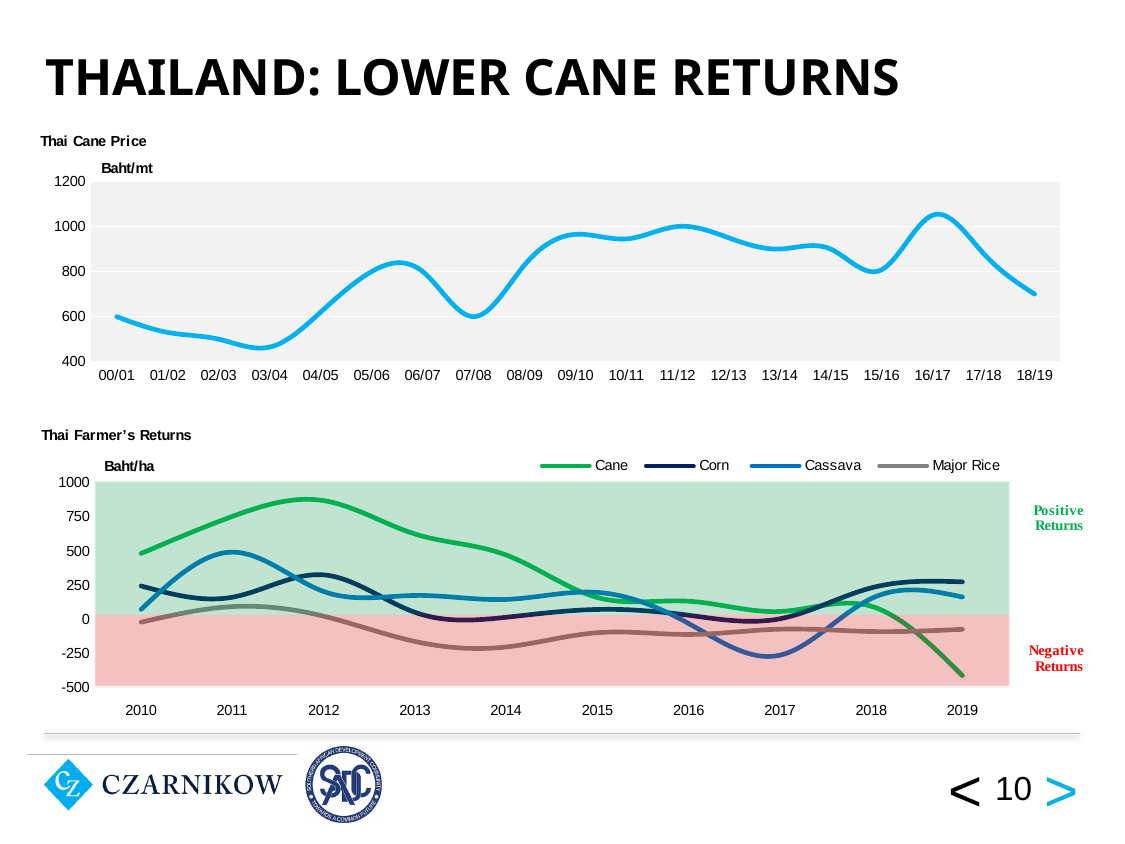
In the Thai Farmer's Returns chart, is the Cane value for 2019 greater or less than -250? less How many seasons are plotted on the x axis of the Thai Cane Price chart? 19 In the Thai Farmer's Returns chart, which is larger in 2012, Cane or Corn? Cane What kind of chart is the Thai Cane Price chart? line chart How many series does the legend of the Thai Farmer's Returns chart list? 4 How many years are plotted on the x axis of the Thai Farmer's Returns chart? 10 In the Thai Farmer's Returns chart, in which year is the Cane series at its highest? 2012 In the Thai Cane Price chart, which season has the lowest cane price? 03/04 In the Thai Cane Price chart, which season has the highest cane price? 16/17 What unit is shown on the y axis of the Thai Farmer's Returns chart? Baht/ha In the Thai Cane Price chart, is the value for 18/19 greater or less than 800? less